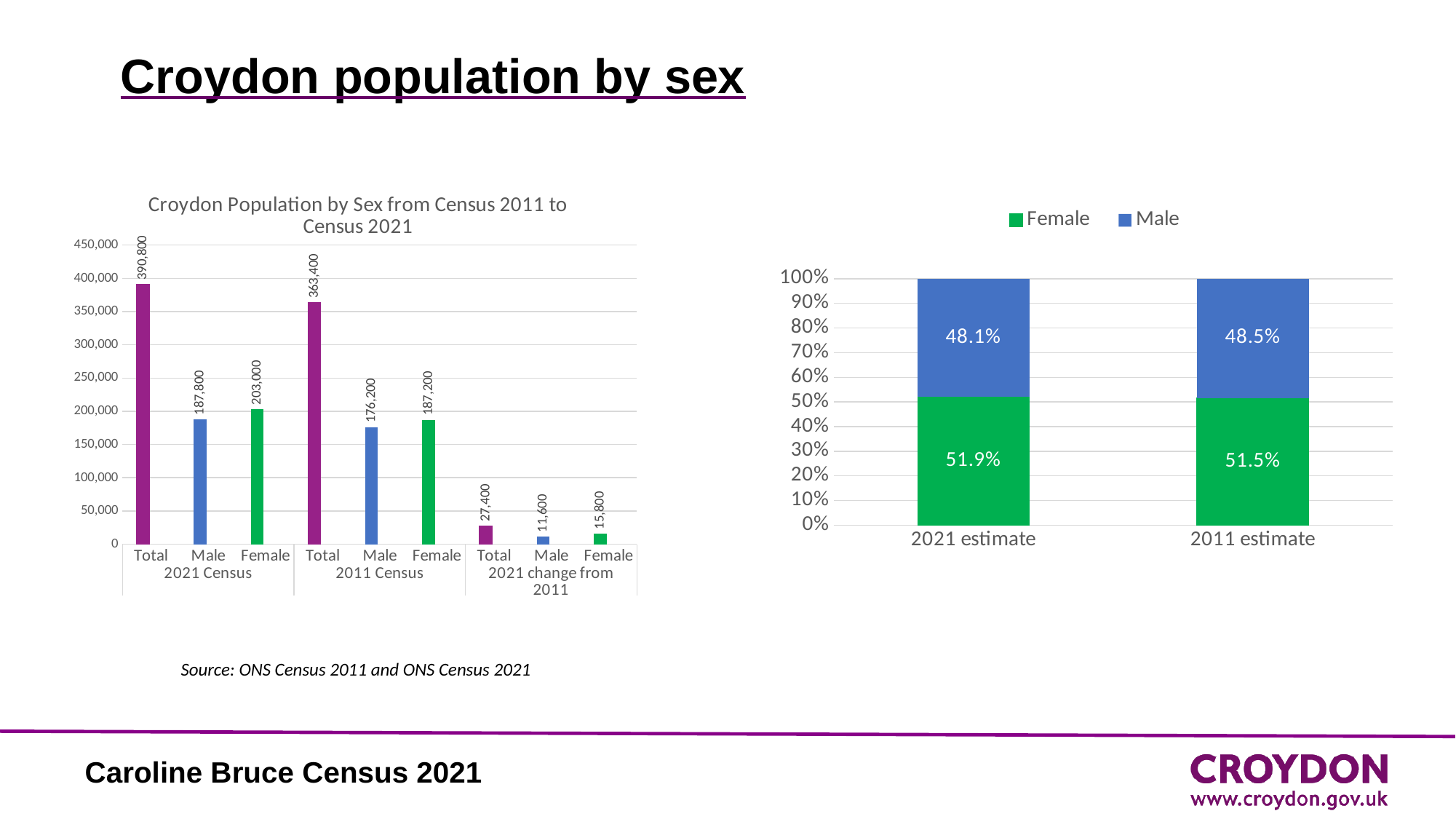
In the chart titled 'Croydon Population by Sex from Census 2011 to Census 2021', what is the difference between the Female and Male values for the 2021 Census? 15,200 How many series does the legend of the stacked bar chart on the right of the slide list? 2 In the chart titled 'Croydon Population by Sex from Census 2011 to Census 2021', which bar has the highest value? Total, 2021 Census In the chart titled 'Croydon Population by Sex from Census 2011 to Census 2021', what is the Female value for the 2011 Census? 187,200 In the stacked bar chart on the right of the slide, what is the Female share for the 2021 estimate? 51.9% In the chart titled 'Croydon Population by Sex from Census 2011 to Census 2021', what is the Total value for the 2021 Census? 390,800 In the stacked bar chart on the right of the slide, what is the Male share for the 2011 estimate? 48.5% In the chart titled 'Croydon Population by Sex from Census 2011 to Census 2021', what is the Male value under '2021 change from 2011'? 11,600 In the chart titled 'Croydon Population by Sex from Census 2011 to Census 2021', which bar has the lowest value? Male, 2021 change from 2011 What kind of chart is the chart on the right of the slide? Stacked bar chart In the chart titled 'Croydon Population by Sex from Census 2011 to Census 2021', which is larger: the Male value for the 2021 Census or the Male value for the 2011 Census? Male, 2021 Census In the chart titled 'Croydon Population by Sex from Census 2011 to Census 2021', how many bars are plotted? 9